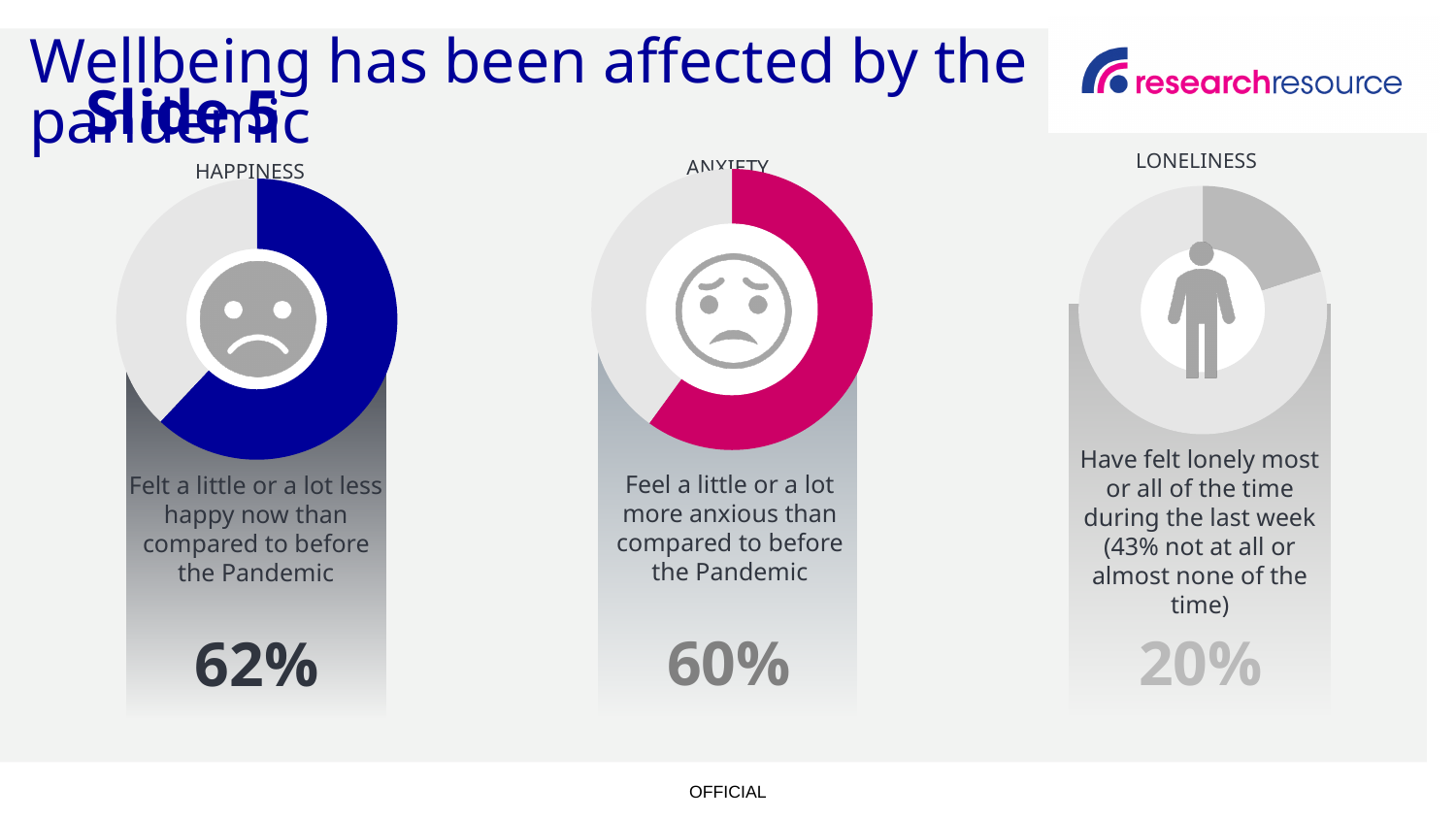
What is the difference between the HAPPINESS chart percentage and the LONELINESS chart percentage? 42 percentage points How many donut charts are shown on the slide? 3 What colour is the filled segment of the HAPPINESS chart? Dark blue Which is larger, the ANXIETY chart percentage or the LONELINESS chart percentage? ANXIETY Is the value shown on the LONELINESS chart greater or less than 50%? less What is the difference between the HAPPINESS chart percentage and the ANXIETY chart percentage? 2 percentage points Which of the three charts (HAPPINESS, ANXIETY, LONELINESS) shows the highest percentage? HAPPINESS What kind of chart is used for HAPPINESS, ANXIETY and LONELINESS on this slide? Donut chart Which of the three charts (HAPPINESS, ANXIETY, LONELINESS) shows the lowest percentage? LONELINESS On the LONELINESS chart, what percentage have felt lonely most or all of the time during the last week? 20% On the ANXIETY chart, what percentage feel a little or a lot more anxious than compared to before the Pandemic? 60% On the HAPPINESS chart, what percentage felt a little or a lot less happy now than compared to before the Pandemic? 62%